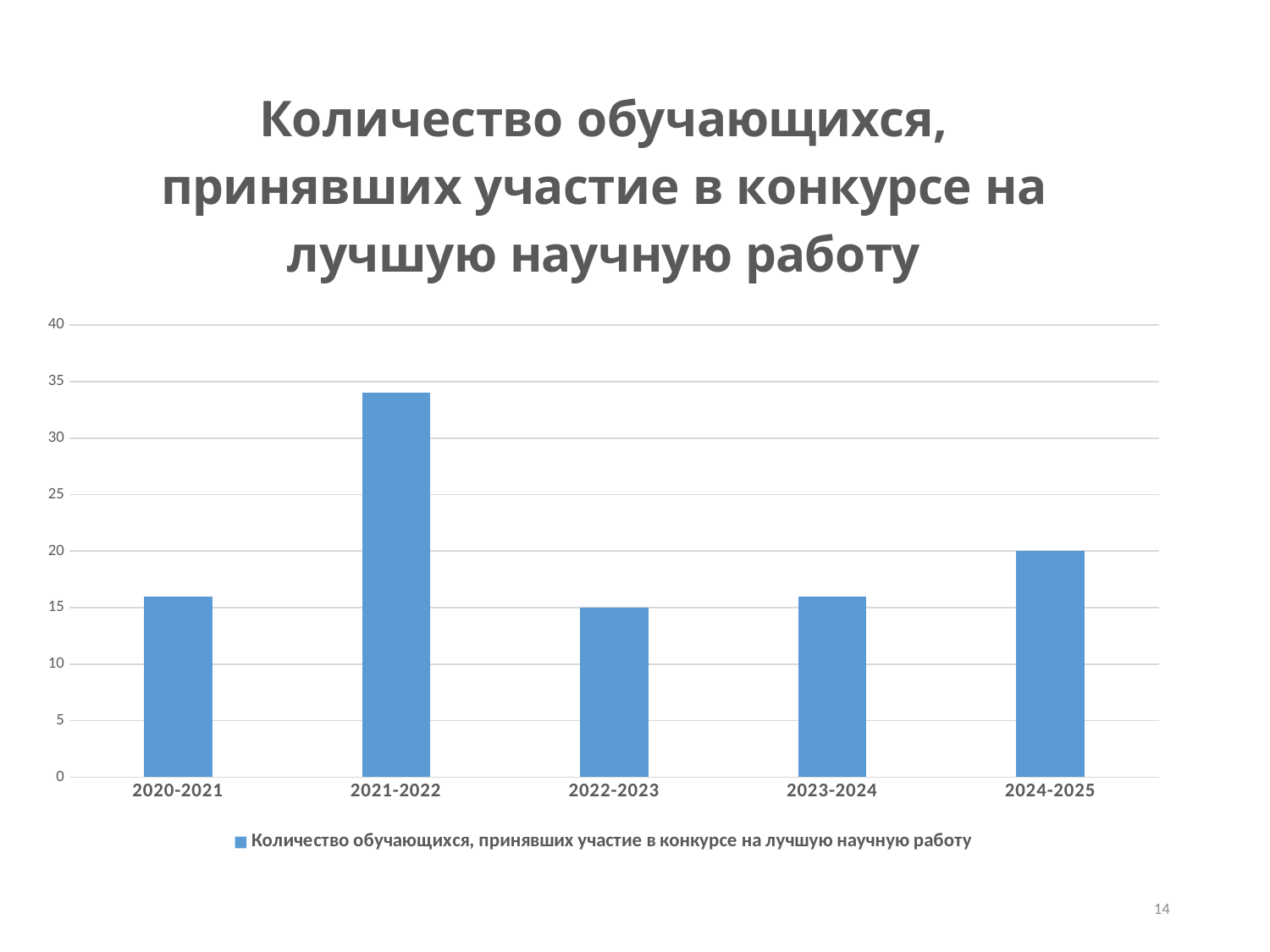
Which academic year has the highest number of students who took part in the competition? 2021-2022 What is the value for 2022-2023? 15 Is the value for 2023-2024 greater or less than 20? less Which is larger, the value for 2024-2025 or the value for 2022-2023? 2024-2025 Is the value for 2020-2021 greater or less than 20? less How many series does the legend list? 1 Which is larger, the value for 2021-2022 or the value for 2024-2025? 2021-2022 What is the value for 2024-2025? 20 Is the value for 2021-2022 greater or less than 30? greater What type of chart is shown on the slide? bar chart What is the title of the chart? Количество обучающихся, принявших участие в конкурсе на лучшую научную работу How many academic years (categories) are shown on the x axis? 5